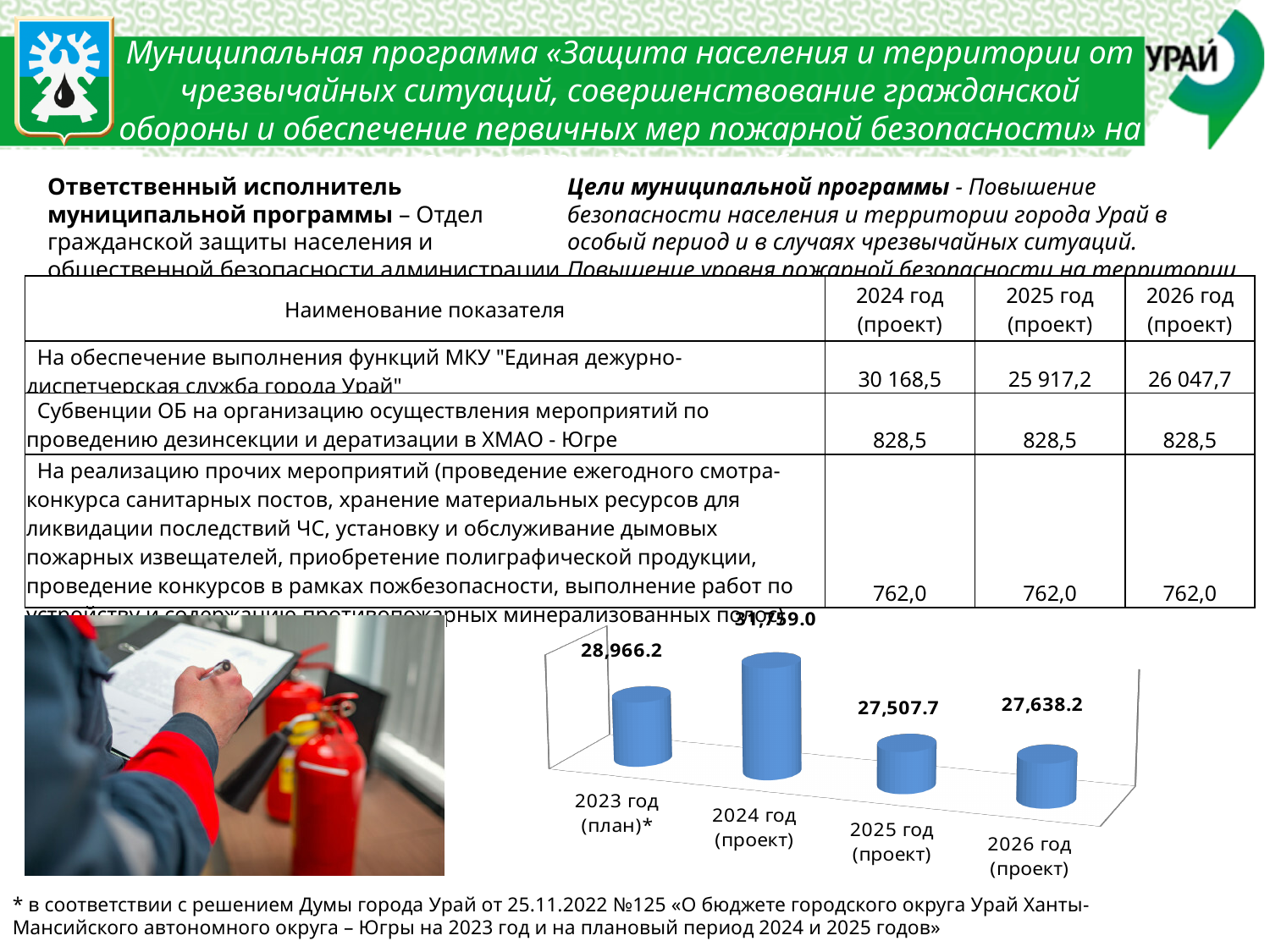
Which is larger, the value for 2023 год (план)* or the value for 2026 год (проект)? 2023 год (план)* What is the difference between the values for 2023 год (план)* and 2025 год (проект)? 1,458.5 Does the value rise or fall from 2024 год (проект) to 2025 год (проект)? fall What is the value shown for 2024 год (проект) in the chart? 31,759.0 What is the value shown for 2023 год (план)* in the chart? 28,966.2 How many categories (years) are plotted in the chart? 4 What is the difference between the values for 2026 год (проект) and 2025 год (проект)? 130.5 What type of chart is shown at the bottom of the slide? bar chart What is the value shown for 2025 год (проект) in the chart? 27,507.7 Which year has the lowest value in the chart? 2025 год (проект) Which year has the highest value in the chart? 2024 год (проект) What is the value shown for 2026 год (проект) in the chart? 27,638.2